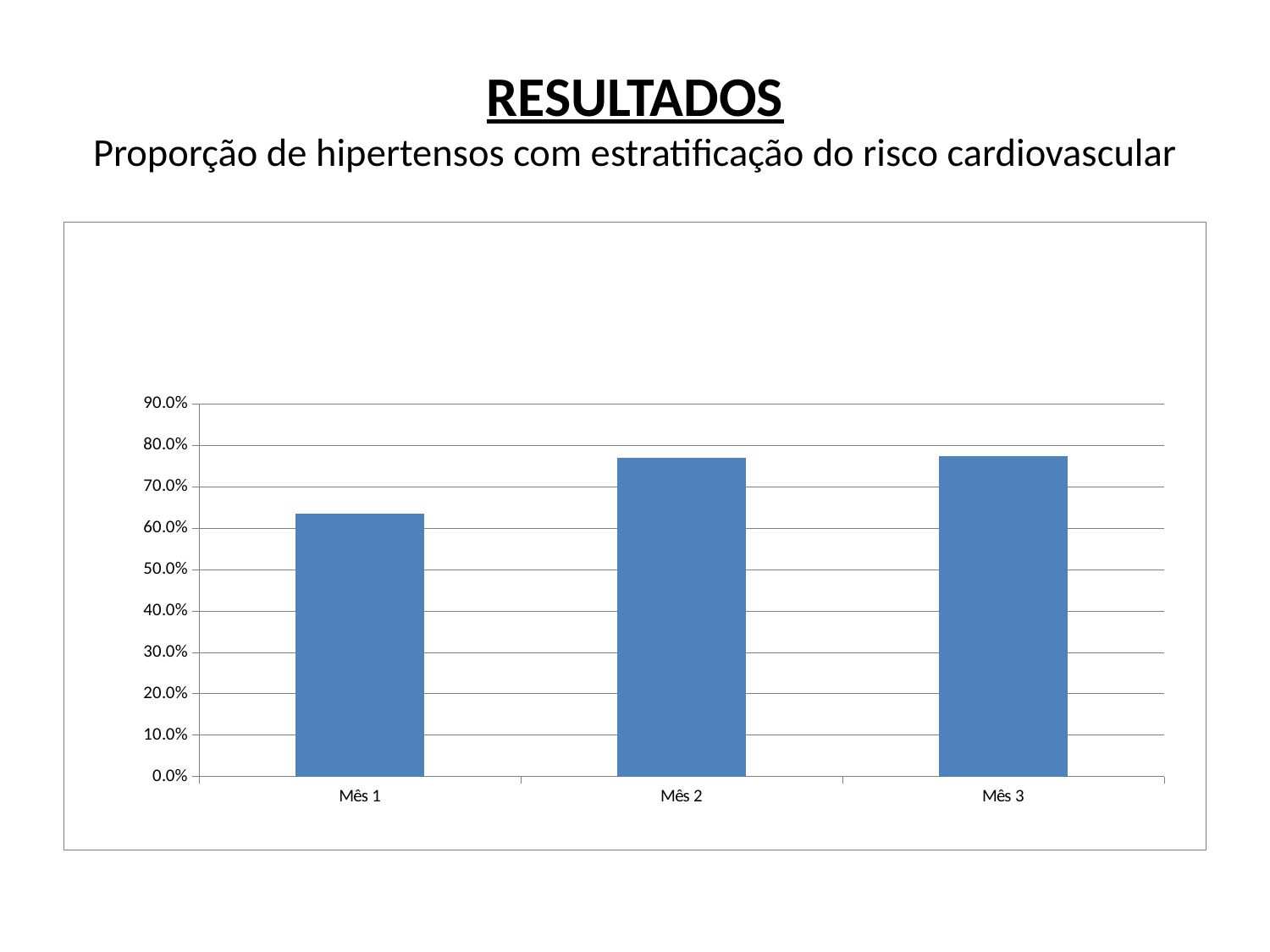
What is the subtitle describing the chart on the slide? Proporção de hipertensos com estratificação do risco cardiovascular Is the value for Mês 1 greater or less than 70.0%? less Is the value for Mês 1 greater or less than 60.0%? greater Is the value for Mês 2 greater or less than 80.0%? less Which is larger, the value for Mês 1 or the value for Mês 3? Mês 3 Which is larger, the value for Mês 1 or the value for Mês 2? Mês 2 What kind of chart is shown on the slide? bar chart Do the values rise or fall from Mês 1 to Mês 3? rise How many categories are plotted on the x axis of the chart? 3 Which category has the lowest value in the chart? Mês 1